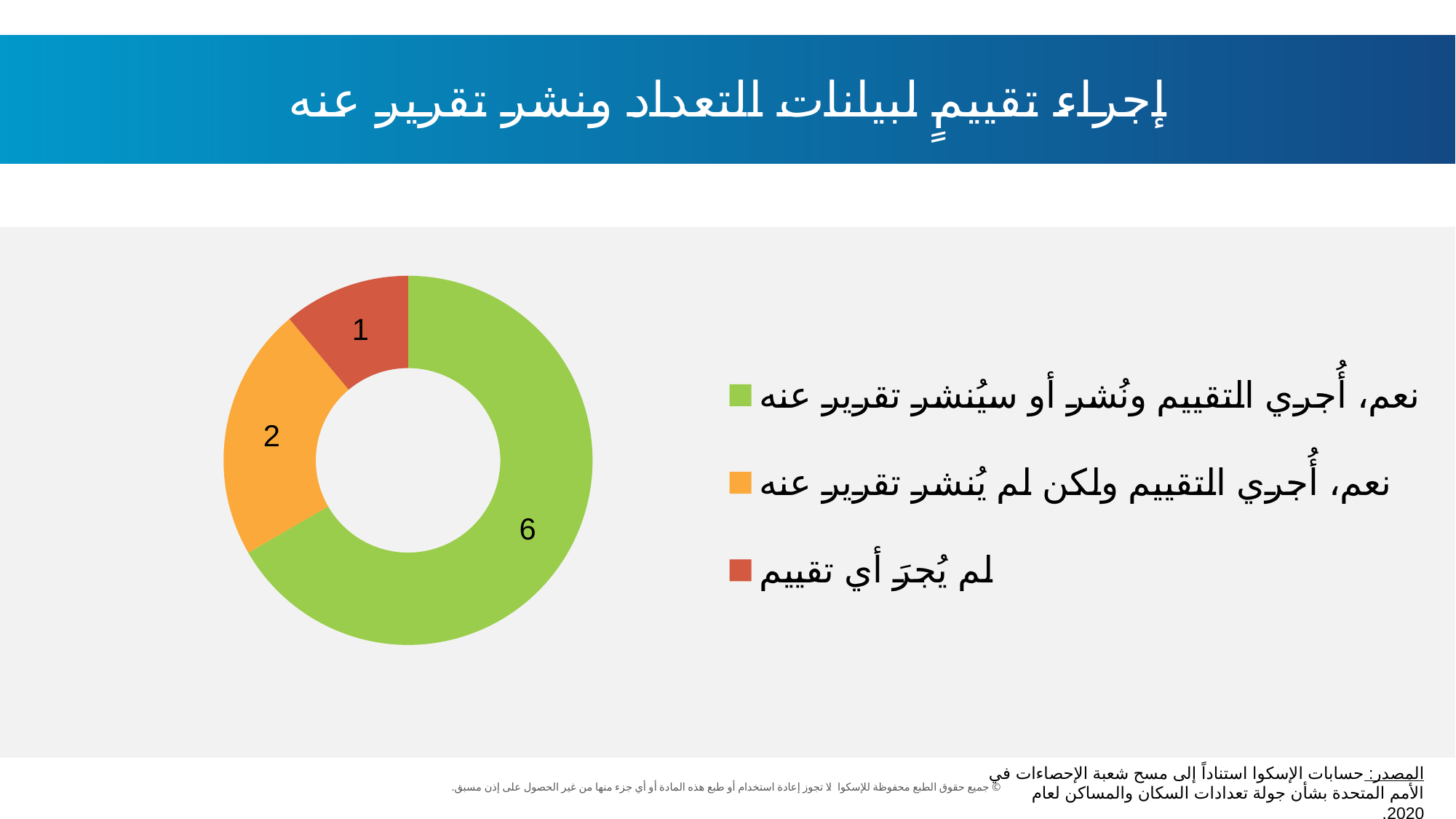
What is the total of all the values shown in the chart? 9 Which category has the lowest value? لم يُجرَ أي تقييم What is the value for the category "نعم، أُجري التقييم ونُشر أو سيُنشر تقرير عنه"? 6 What is the difference between the value for "نعم، أُجري التقييم ونُشر أو سيُنشر تقرير عنه" and the value for "نعم، أُجري التقييم ولكن لم يُنشر تقرير عنه"? 4 What type of chart is shown on the slide? Donut (pie) chart How many entries does the legend list? 3 What is the value for the category "لم يُجرَ أي تقييم"? 1 How many categories does the chart show? 3 What is the value for the category "نعم، أُجري التقييم ولكن لم يُنشر تقرير عنه"? 2 Which is larger: the value for "نعم، أُجري التقييم ولكن لم يُنشر تقرير عنه" or the value for "لم يُجرَ أي تقييم"? نعم، أُجري التقييم ولكن لم يُنشر تقرير عنه Which category has the highest value? نعم، أُجري التقييم ونُشر أو سيُنشر تقرير عنه What colour represents the category "لم يُجرَ أي تقييم" in the chart? Red